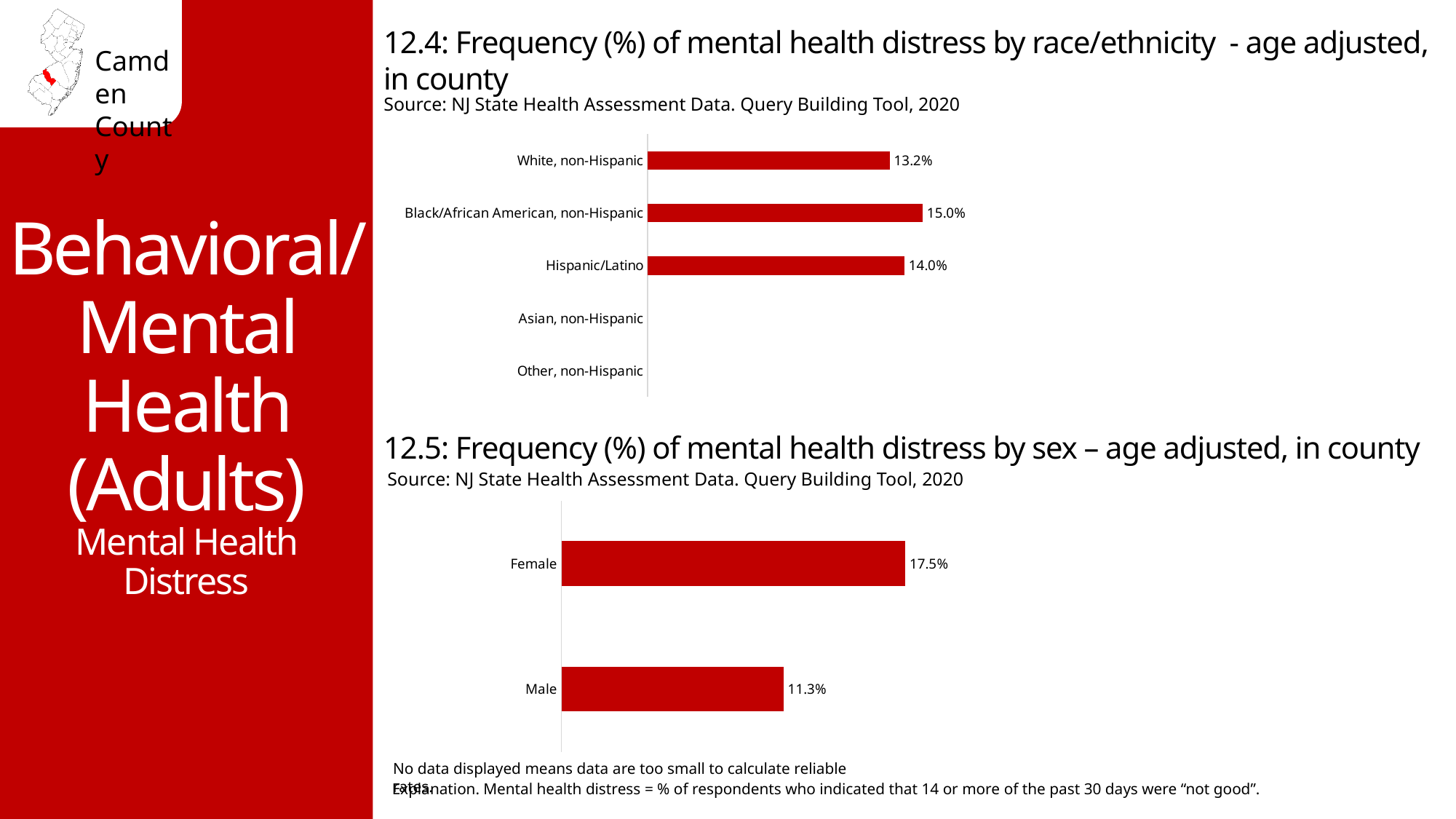
In the chart '12.4: Frequency (%) of mental health distress by race/ethnicity', which category has the highest value among those with data shown? Black/African American, non-Hispanic In the chart '12.4: Frequency (%) of mental health distress by race/ethnicity', what is the value for White, non-Hispanic? 13.2% What type of chart is '12.5: Frequency (%) of mental health distress by sex'? Bar chart In the chart '12.4: Frequency (%) of mental health distress by race/ethnicity', which categories have no bar displayed? Asian, non-Hispanic and Other, non-Hispanic In the chart '12.4: Frequency (%) of mental health distress by race/ethnicity', what is the value for Black/African American, non-Hispanic? 15.0% In the chart '12.5: Frequency (%) of mental health distress by sex', what is the value for Male? 11.3% In the chart '12.5: Frequency (%) of mental health distress by sex', which is larger, the value for Female or for Male? Female In the chart '12.4: Frequency (%) of mental health distress by race/ethnicity', what is the difference between the values for Black/African American, non-Hispanic and White, non-Hispanic? 1.8% In the chart '12.4: Frequency (%) of mental health distress by race/ethnicity', how many race/ethnicity categories are listed on the axis? 5 In the chart '12.5: Frequency (%) of mental health distress by sex', what is the value for Female? 17.5% In the chart '12.4: Frequency (%) of mental health distress by race/ethnicity', what is the value for Hispanic/Latino? 14.0% In the chart '12.5: Frequency (%) of mental health distress by sex', what is the difference between the Female and Male values? 6.2%